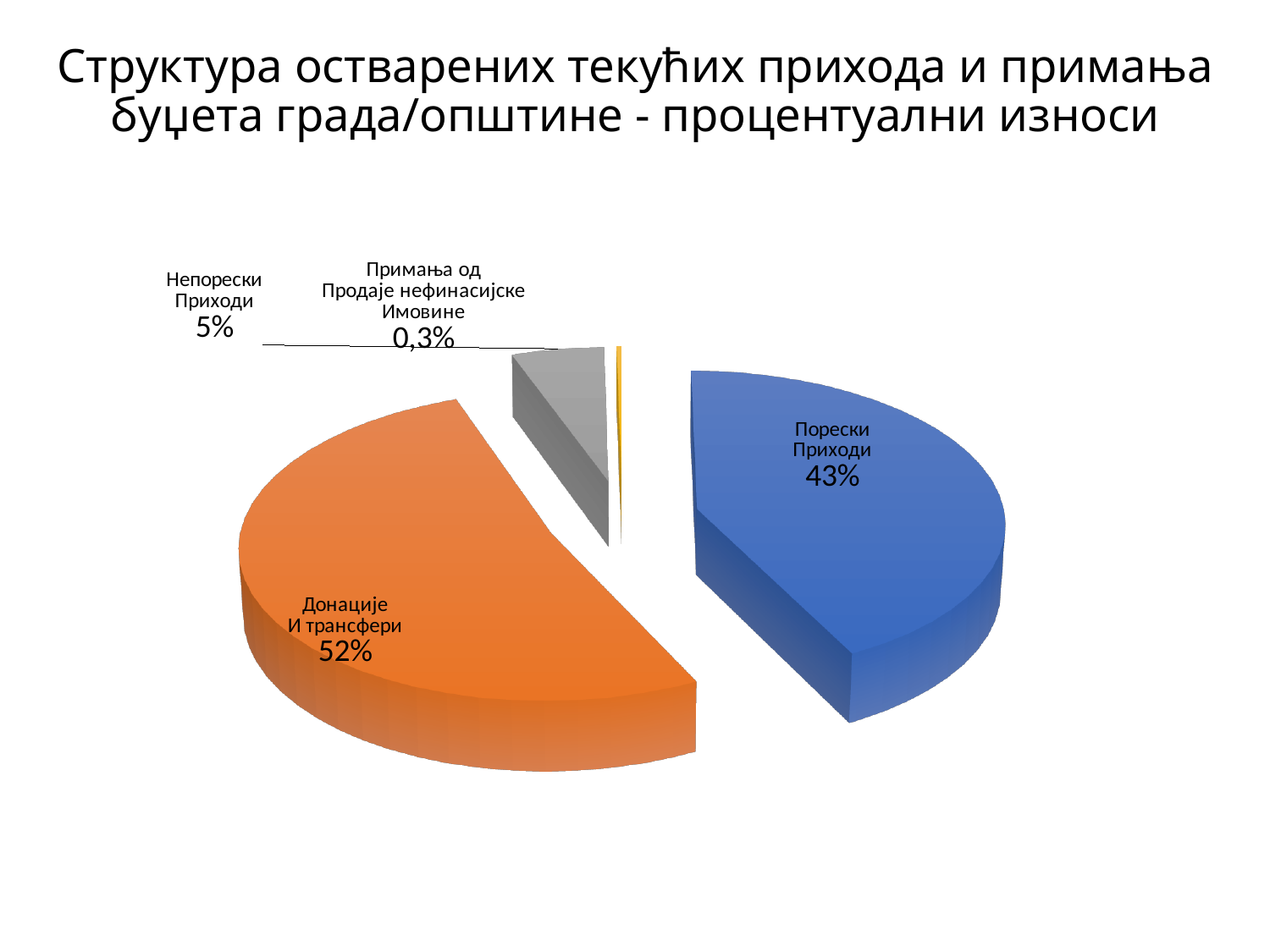
What kind of chart is shown on the slide? pie chart What share of the pie is Примања од Продаје нефинасијске Имовине? 0,3% What share of the pie is Порески Приходи? 43% What share of the pie is Донације И трансфери? 52% What colour is the slice for Порески Приходи? blue What is the difference in percentage points between Донације И трансфери and Порески Приходи? 9 Which category has the smallest slice of the pie? Примања од Продаје нефинасијске Имовине What colour is the slice for Донације И трансфери? orange How many slices does the pie chart have? 4 Which is larger, the share for Порески Приходи or the share for Непорески Приходи? Порески Приходи Which category has the largest slice of the pie? Донације И трансфери